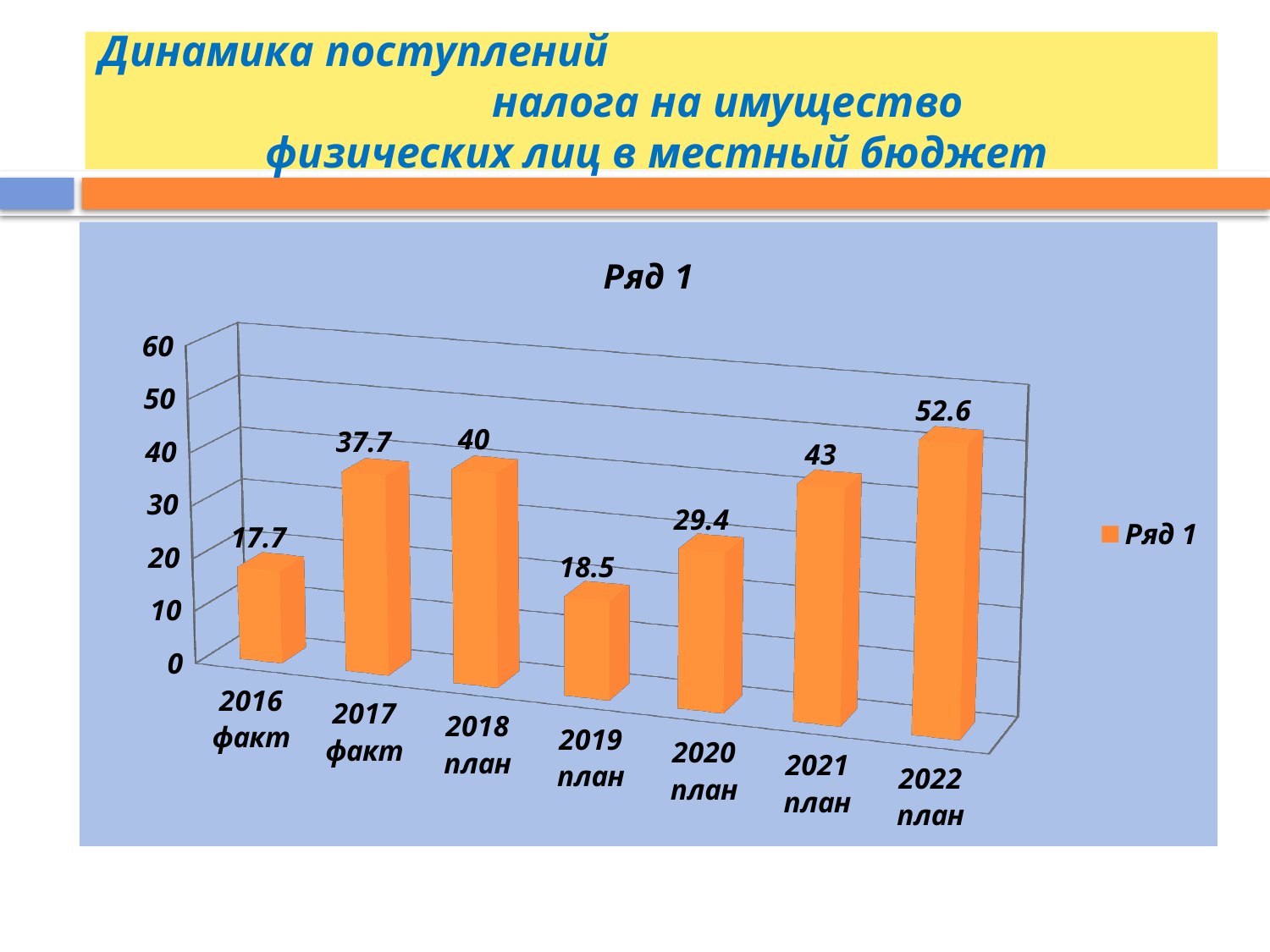
What is the value for 2016 факт? 17.7 What is the value for 2021 план? 43 Which is larger, the value for 2017 факт or the value for 2020 план? 2017 факт What is the title of the chart? Ряд 1 What is the value for 2019 план? 18.5 How many categories are shown on the x axis? 7 What is the difference between the values for 2022 план and 2021 план? 9.6 Which category has the lowest value? 2016 факт Which category has the highest value? 2022 план What kind of chart is shown on the slide? bar chart What is the difference between the values for 2018 план and 2019 план? 21.5 How many series does the legend list? 1